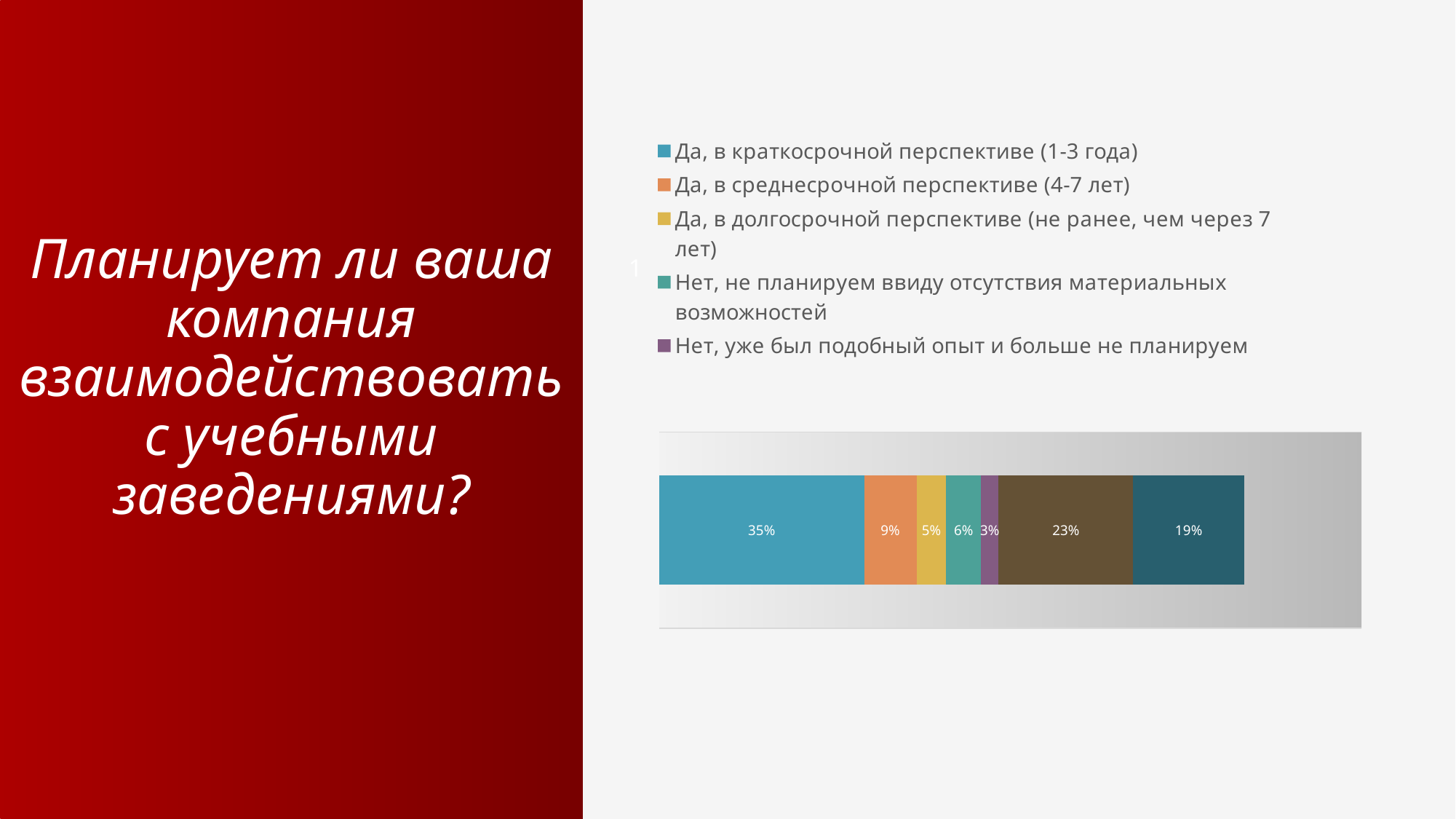
What is the value for "Да, в долгосрочной перспективе (не ранее, чем через 7 лет)"? 5% What kind of chart is shown on the slide? Stacked bar chart How many entries does the legend list? 5 What is the value for "Да, в краткосрочной перспективе (1-3 года)"? 35% What is the value for "Да, в среднесрочной перспективе (4-7 лет)"? 9% What is the value for "Нет, не планируем ввиду отсутствия материальных возможностей"? 6% How many segments make up the stacked bar? 7 Which legend entry has the lowest value? Нет, уже был подобный опыт и больше не планируем What is the difference between the values for "Да, в краткосрочной перспективе (1-3 года)" and "Да, в среднесрочной перспективе (4-7 лет)"? 26% Which is larger: "Да, в среднесрочной перспективе (4-7 лет)" or "Да, в долгосрочной перспективе (не ранее, чем через 7 лет)"? Да, в среднесрочной перспективе (4-7 лет) What is the value for "Нет, уже был подобный опыт и больше не планируем"? 3% Which legend entry has the highest value? Да, в краткосрочной перспективе (1-3 года)